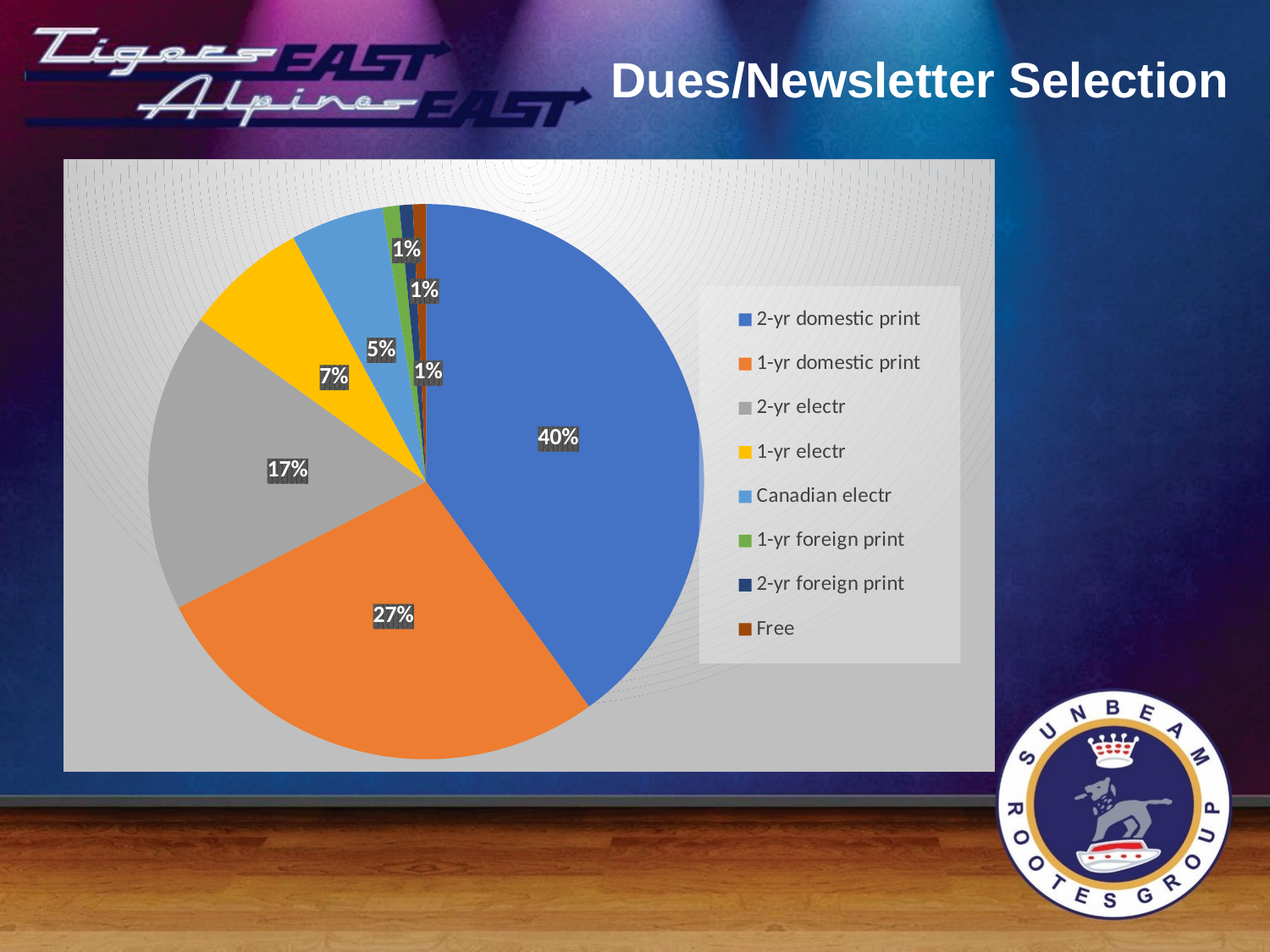
What share of the pie does 2-yr domestic print have? 40% What is the value shown for Canadian electr? 5% What is the value shown for 1-yr electr? 7% What is the difference between the 2-yr domestic print share and the 1-yr domestic print share? 13% What is the value shown for 2-yr electr? 17% Which category has the largest slice of the pie? 2-yr domestic print What is the title of the slide containing the chart? Dues/Newsletter Selection What is the combined share of 1-yr electr and Canadian electr? 12% How many categories does the legend list? 8 Which is larger, the share for 2-yr electr or the share for 1-yr electr? 2-yr electr What share of the pie does 1-yr domestic print have? 27% What kind of chart is shown on the slide? Pie chart